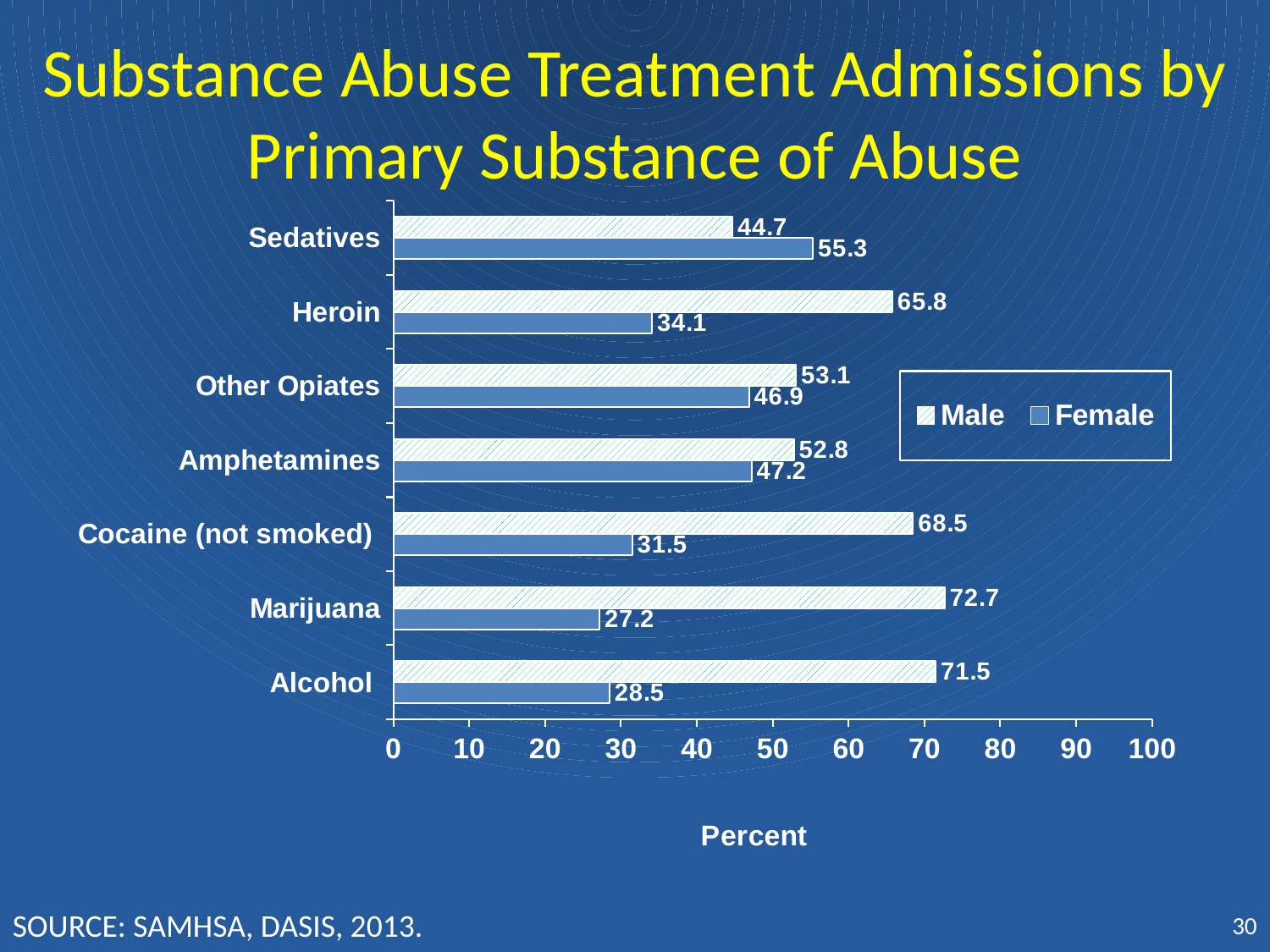
What is the label of the horizontal axis? Percent What is the Female value for Heroin? 34.1 What is the Female value for Sedatives? 55.3 Which category has the lowest Female value? Marijuana What is the Male value for Marijuana? 72.7 How many series does the legend list? 2 Which is larger, the Male value for Other Opiates or the Male value for Cocaine (not smoked)? Cocaine (not smoked) What kind of chart is shown on the slide? Bar chart Which category has the highest Male value? Marijuana Which category has the lowest Male value? Sedatives What is the difference between the Male and Female values for Alcohol? 43 How many categories are shown on the chart? 7